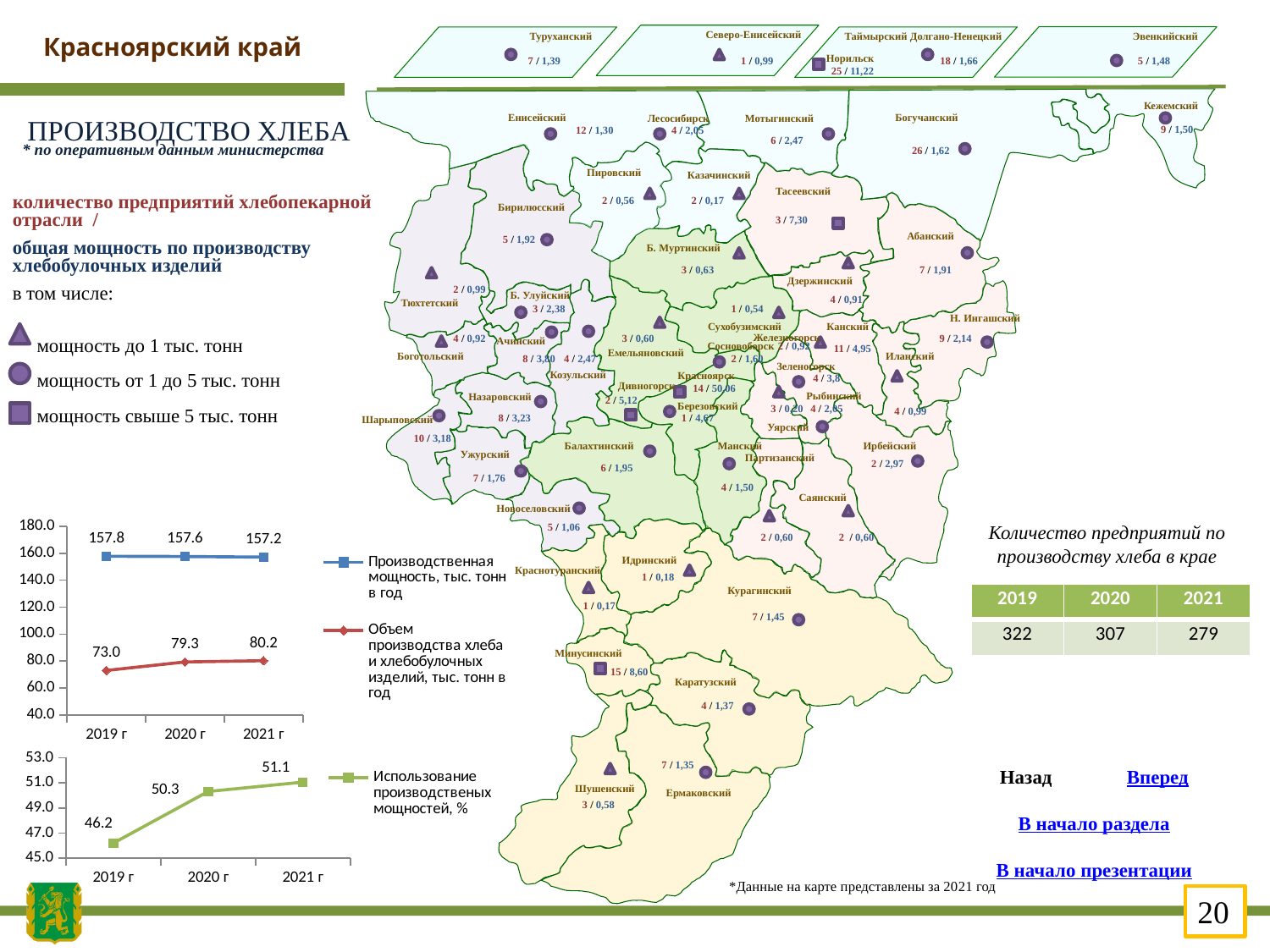
In the upper line chart, which year has the highest value for 'Объем производства хлеба и хлебобулочных изделий'? 2021 г In the upper line chart, which is larger in 2021 г: 'Производственная мощность' or 'Объем производства'? Производственная мощность How many series does the legend of the upper line chart list? 2 In the upper line chart, what is the value of 'Производственная мощность, тыс. тонн в год' for 2019 г? 157.8 In the upper line chart, what is the difference between 'Объем производства' in 2020 г and 2019 г? 6.3 In the upper line chart, what is the value of 'Объем производства хлеба и хлебобулочных изделий, тыс. тонн в год' for 2021 г? 80.2 What kind of chart is the lower chart showing 'Использование производственных мощностей, %'? Line chart In the lower line chart, what is the difference between the 2021 г and 2019 г values? 4.9 In the lower line chart, what is the value of 'Использование производственных мощностей, %' for 2020 г? 50.3 In the lower line chart, do the values rise or fall from 2019 г to 2021 г? Rise How many years are plotted on the x axis of the lower line chart? 3 In the lower line chart, which year has the lowest value? 2019 г